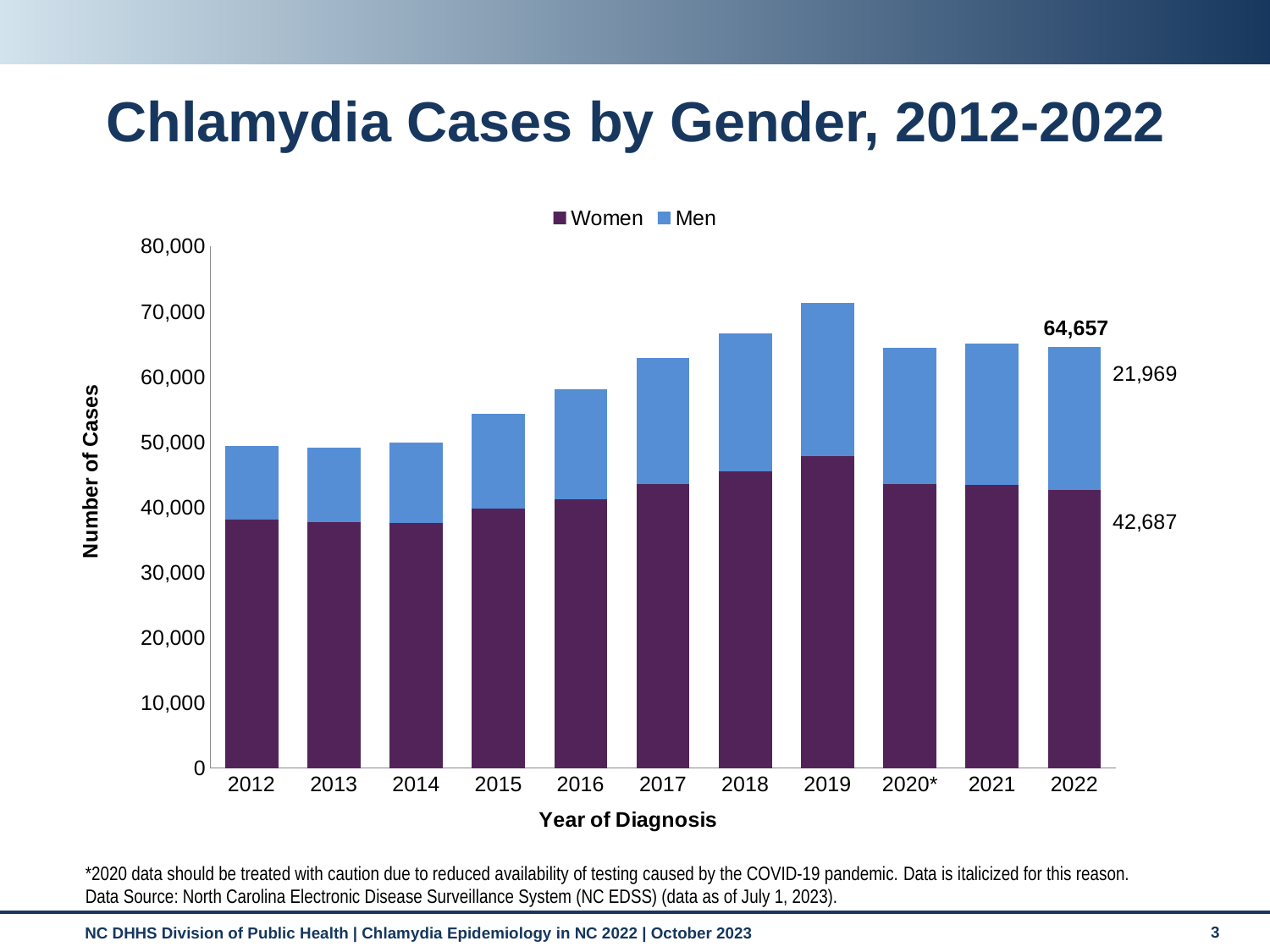
Is the number of cases among women in 2012 greater or less than 40,000? less Do total cases rise or fall from 2012 to 2019? rise In 2022, which group had more cases, women or men? Women How many years are shown on the x axis? 11 Is the total number of cases in 2019 greater or less than 70,000? greater What is the total number of chlamydia cases in 2022? 64,657 What is the number of chlamydia cases among men in 2022? 21,969 What is the number of chlamydia cases among women in 2022? 42,687 How many series does the legend list? 2 Which year has the highest total number of cases? 2019 What kind of chart is shown on the slide? Stacked bar chart In 2022, how many more cases were there among women than among men? 20,718